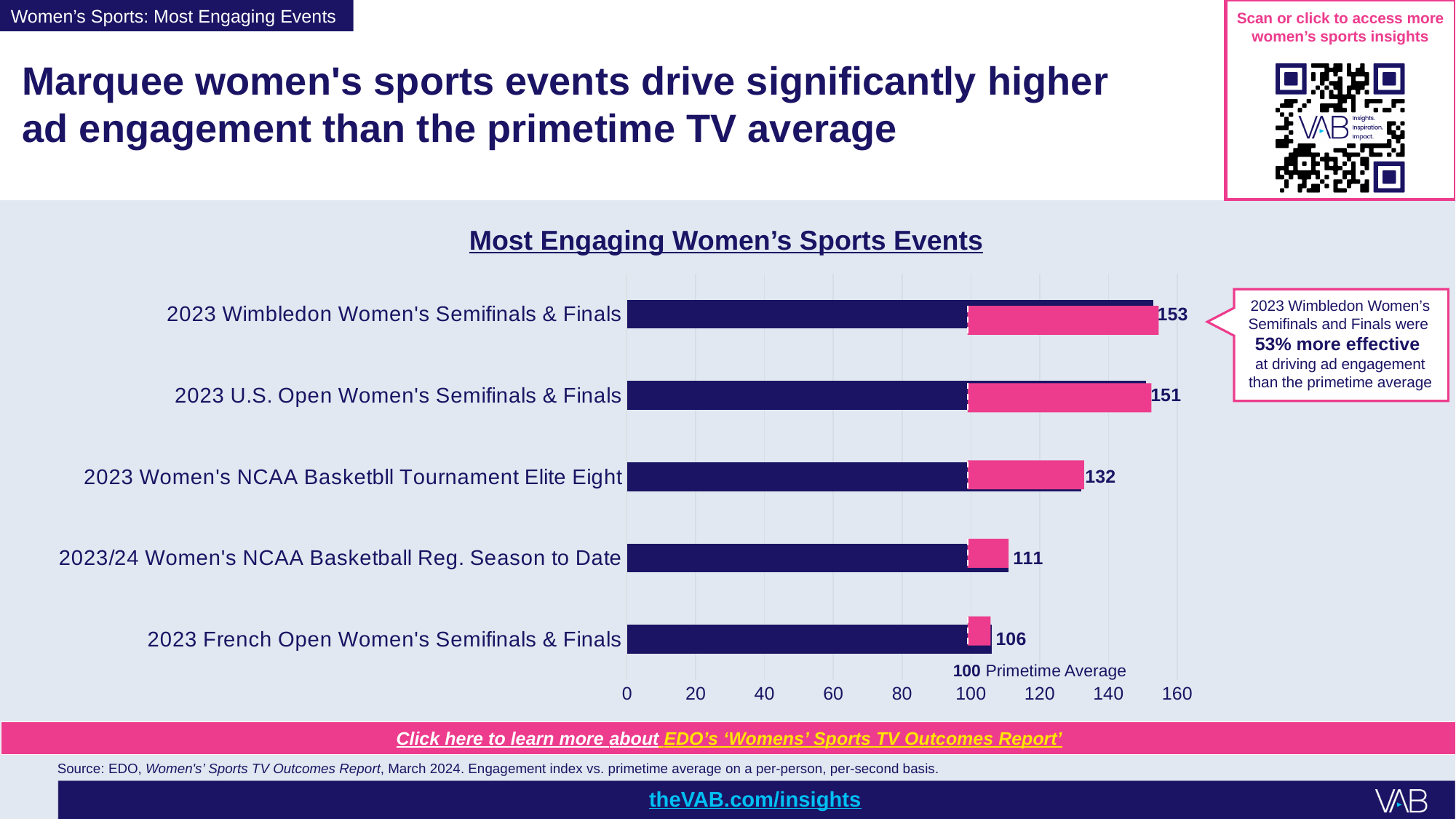
What is the value for 2023 French Open Women's Semifinals & Finals? 106 What is the difference between the values for 2023 Wimbledon Women's Semifinals & Finals and 2023 French Open Women's Semifinals & Finals? 47 Which event has the lowest value? 2023 French Open Women's Semifinals & Finals Which is larger: the value for 2023 Women's NCAA Basketbll Tournament Elite Eight or 2023/24 Women's NCAA Basketball Reg. Season to Date? 2023 Women's NCAA Basketbll Tournament Elite Eight Which event has the highest value? 2023 Wimbledon Women's Semifinals & Finals How many events are shown in the chart? 5 What kind of chart is shown? Bar chart What is the title of the chart? Most Engaging Women's Sports Events What is the value for 2023 Wimbledon Women's Semifinals & Finals? 153 What is the value for 2023/24 Women's NCAA Basketball Reg. Season to Date? 111 What is the value for 2023 U.S. Open Women's Semifinals & Finals? 151 What is the value for 2023 Women's NCAA Basketbll Tournament Elite Eight? 132